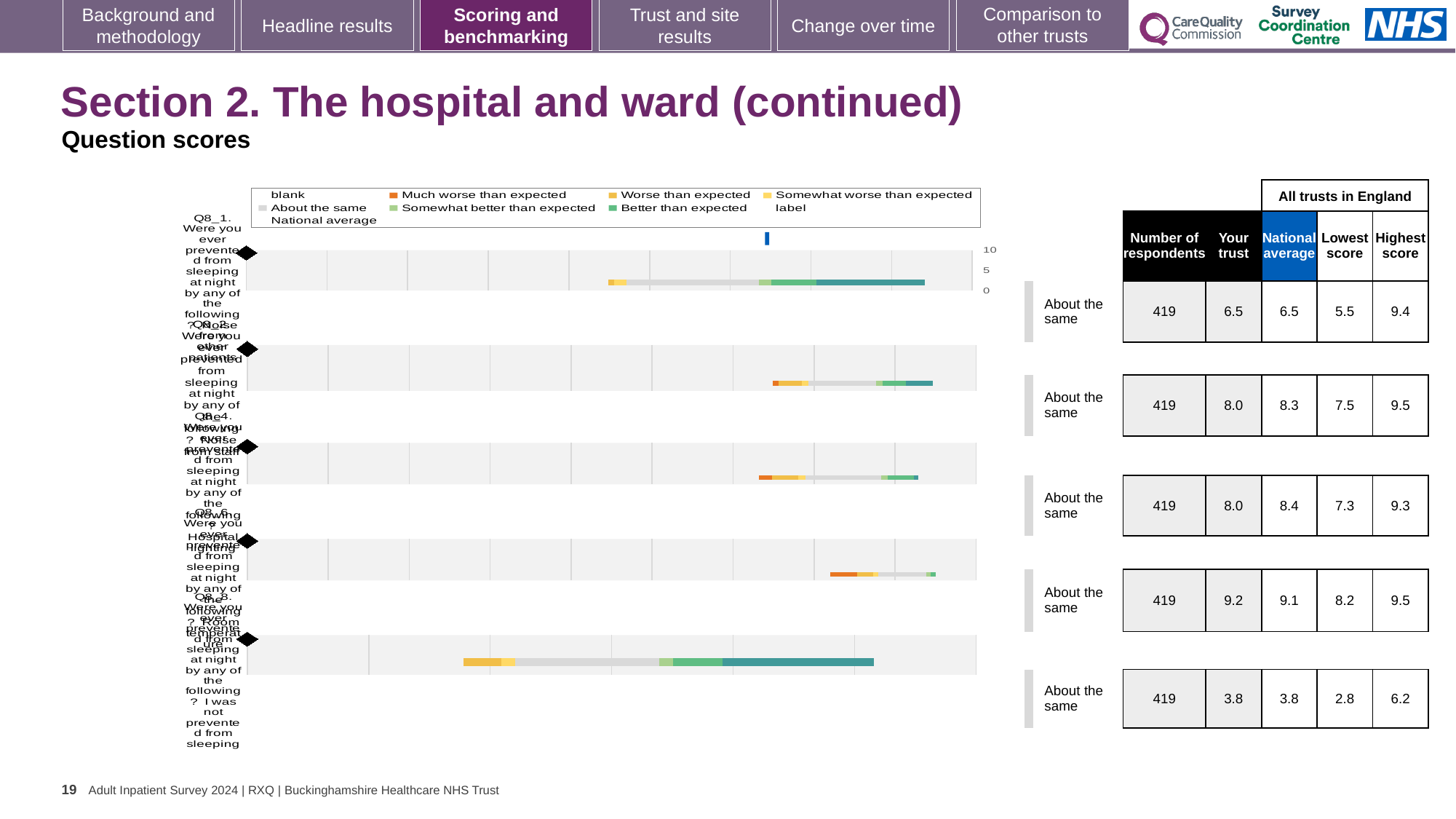
What is the national average score for Q8_2? 8.3 What is the lowest score among all trusts in England for Q8_8? 2.8 Which question has the lowest 'Your trust' score? Q8_8 How many question rows (bars) does the chart show? 5 For Q8_4, what is the difference between the national average and the 'Your trust' score? 0.4 What is the highest score among all trusts in England for Q8_6? 9.5 For Q8_6, which is larger: the 'Your trust' score or the national average? Your trust What benchmark rating is shown for Q8_2? About the same What is the 'Your trust' score for Q8_1? 6.5 How many respondents are listed for Q8_1? 419 What kind of chart is shown on the slide? bar chart Which question has the highest 'Your trust' score? Q8_6